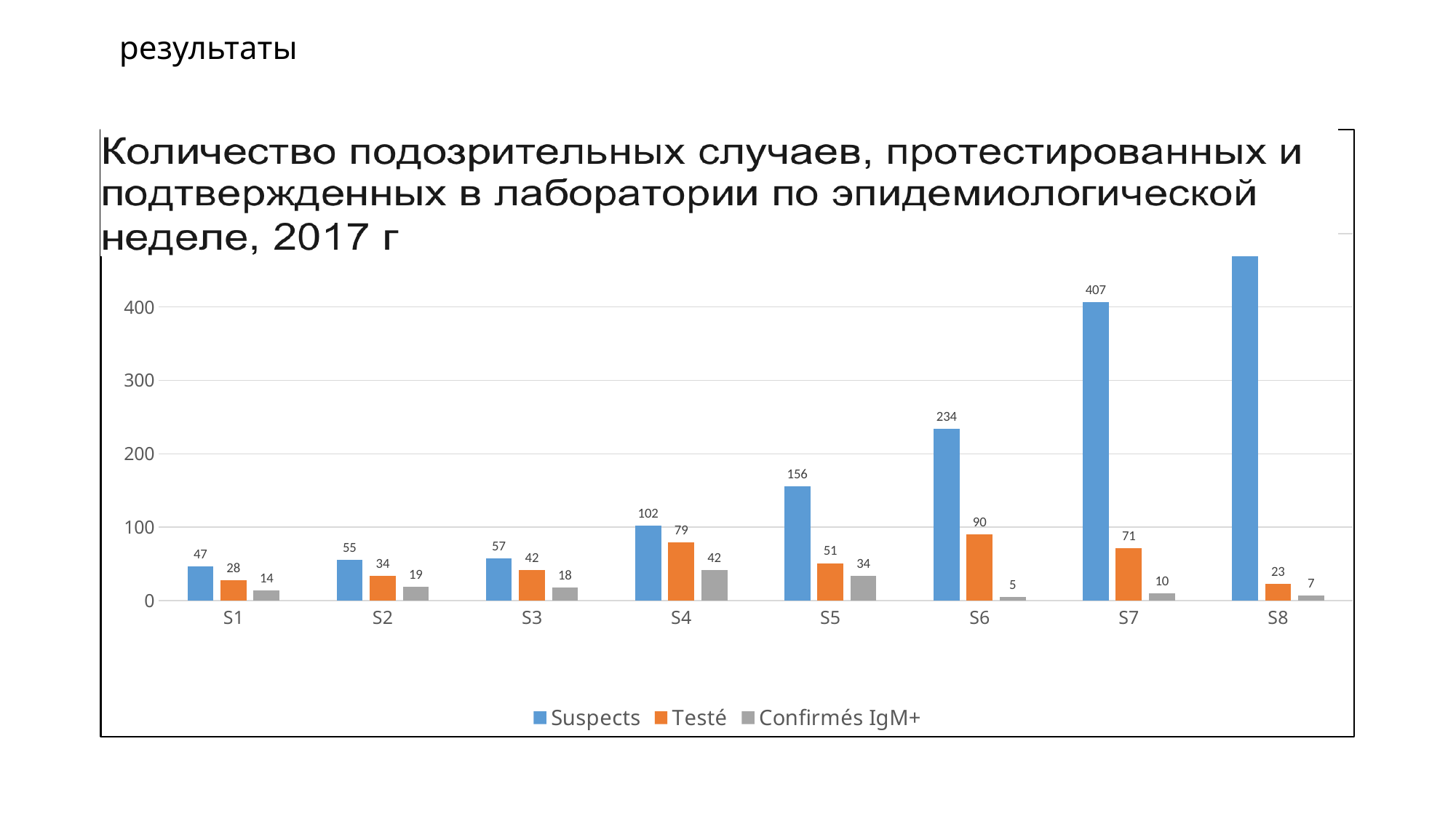
How many series does the legend list? 3 What is the value of Confirmés IgM+ for S6? 5 Which week has the highest Testé value? S6 What kind of chart is shown on the slide? bar chart What is the difference between Suspects and Testé for S5? 105 Is the Suspects value for S8 greater or less than 400? greater Which is larger, the Testé value for S3 or the Testé value for S2? S3 Do the Suspects values rise or fall from S1 to S8? rise What is the value of Suspects for S7? 407 How many weeks (categories) are shown on the x axis? 8 What is the value of Testé for S4? 79 Which week has the lowest Confirmés IgM+ value? S6